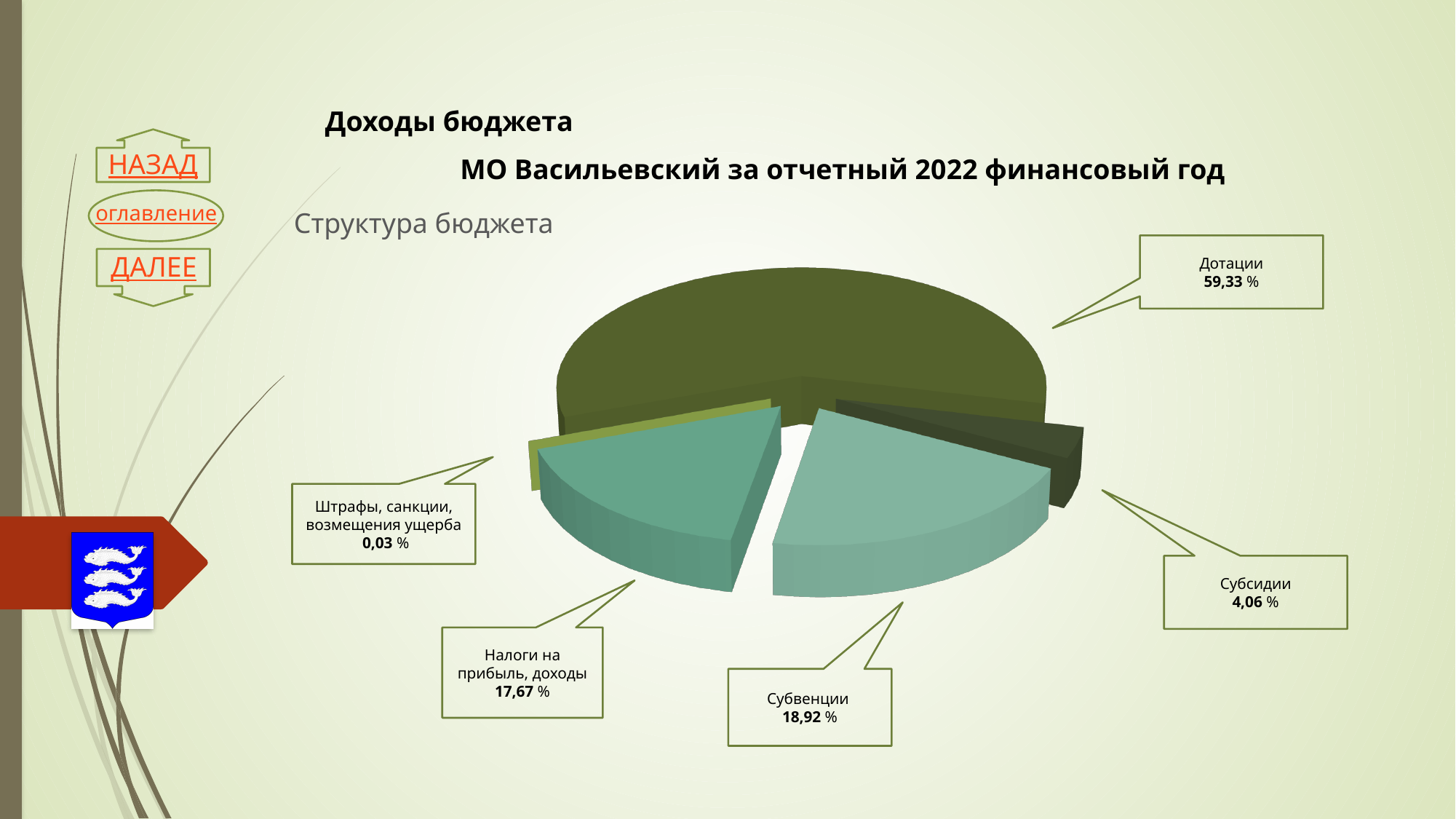
Which category has the smallest share of the budget? Штрафы, санкции, возмещения ущерба What is the title of the chart? Структура бюджета What share of the budget is Штрафы, санкции, возмещения ущерба? 0,03 % What share of the budget is Субвенции? 18,92 % What share of the budget is Дотации? 59,33 % What share of the budget is Субсидии? 4,06 % What share of the budget is Налоги на прибыль, доходы? 17,67 % How many categories are shown in the pie chart? 5 Which is larger: Субвенции or Налоги на прибыль, доходы? Субвенции What is the difference in percentage points between Дотации and Субвенции? 40,41 Which category has the largest share of the budget? Дотации What kind of chart is shown on the slide? Pie chart